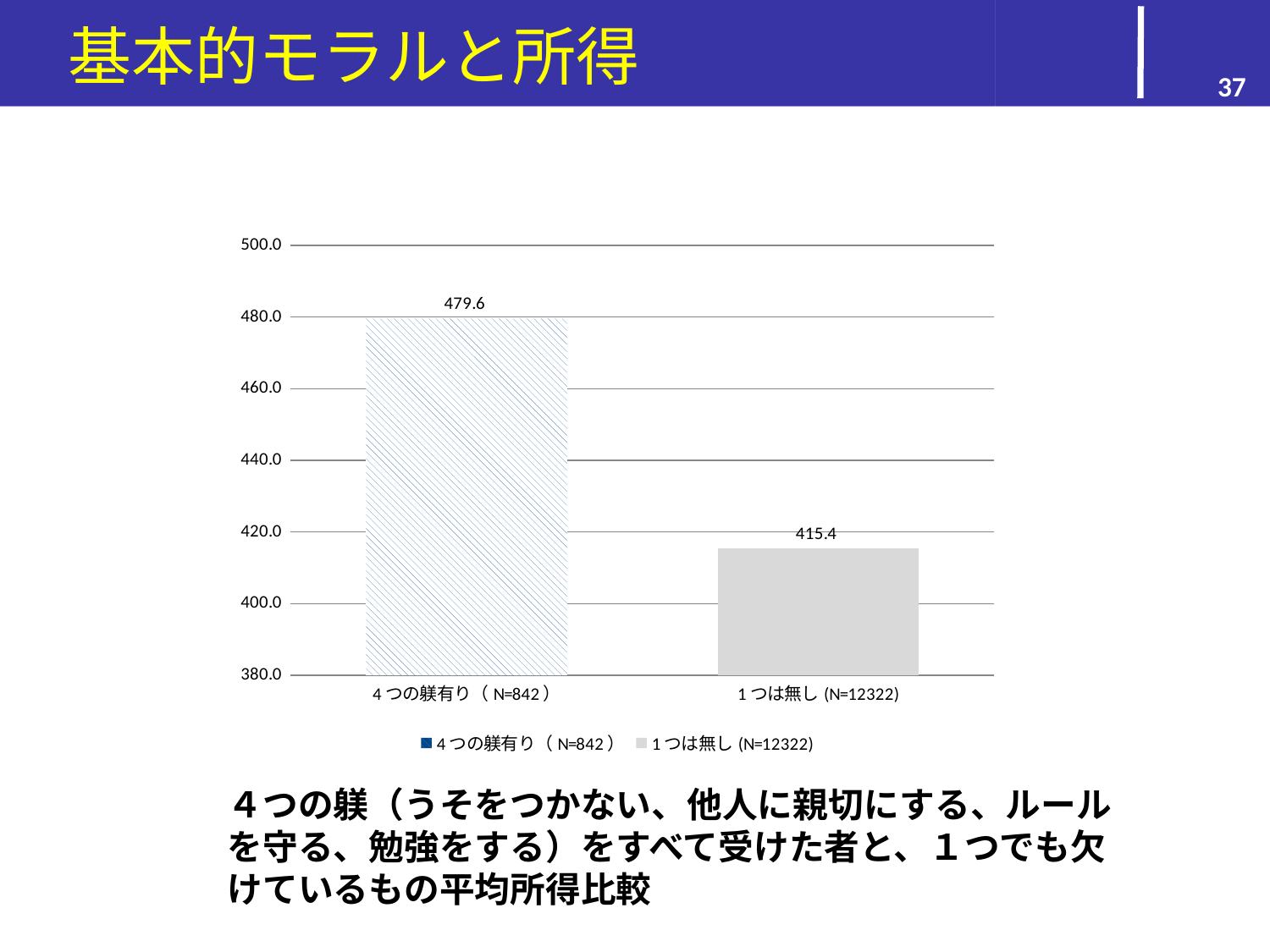
Which category has the highest value? ４つの躾有り（N=842） What is the value for ４つの躾有り（N=842）? 479.6 Is the value for １つは無し (N=12322) greater or less than 420.0? less How many entries does the legend list? 2 What is the value for １つは無し (N=12322)? 415.4 What is the difference between the values for ４つの躾有り（N=842） and １つは無し (N=12322)? 64.2 How many bars are plotted in the chart? 2 What is the lowest value shown on the vertical axis? 380.0 Which category has the lowest value? １つは無し (N=12322) Which is larger, the value for ４つの躾有り（N=842） or the value for １つは無し (N=12322)? ４つの躾有り（N=842） Is the value for ４つの躾有り（N=842） greater or less than 460.0? greater What kind of chart is shown on the slide? bar chart